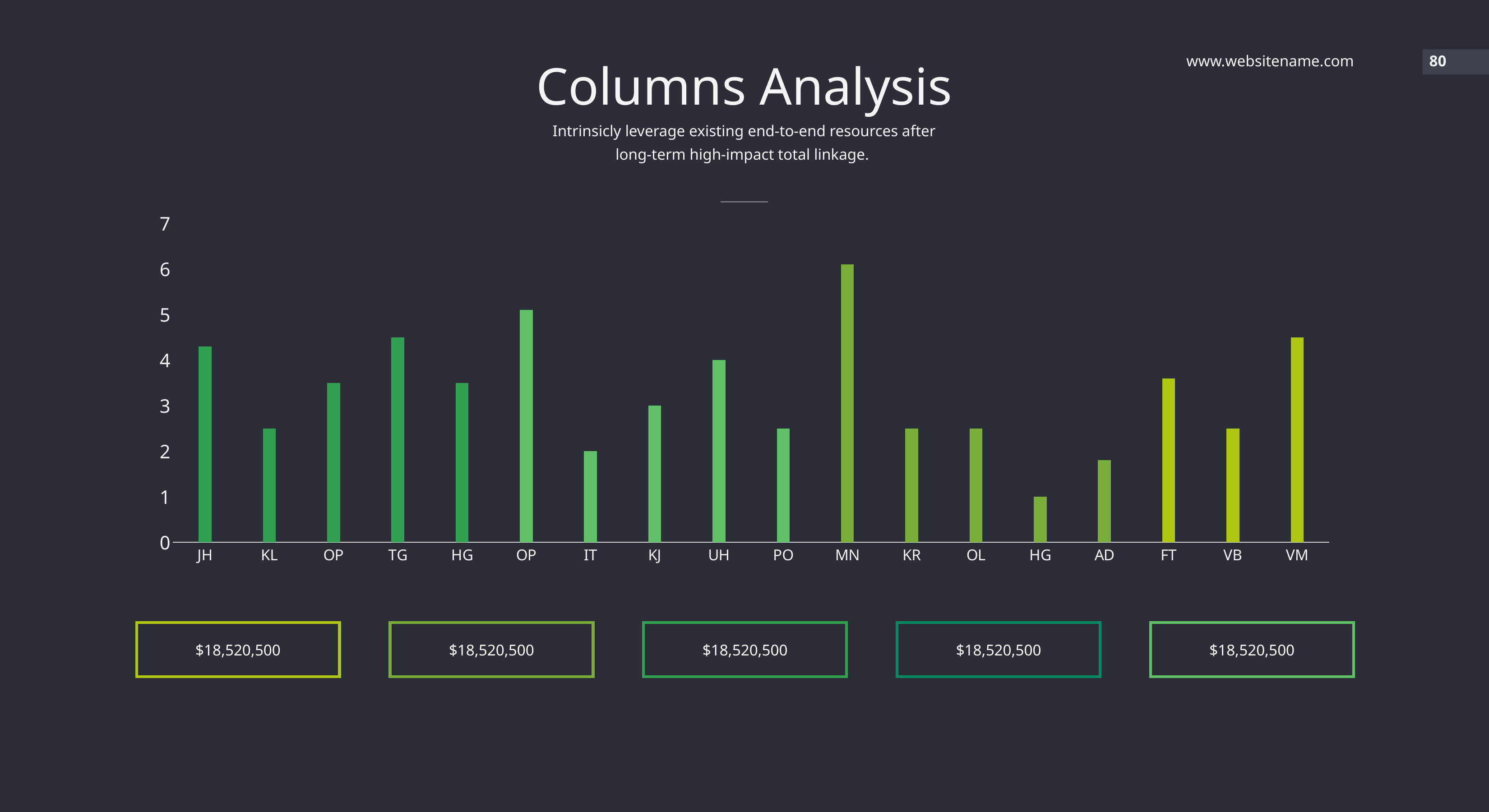
Which category has the highest bar in the chart? MN Is the value for JH greater or less than 4? greater Which is larger, the value for VB or the value for VM? VM Is the value for FT greater or less than 3? greater Is the value for AD greater or less than 2? less How many categories are plotted along the x axis of the chart? 18 What is the title of the chart on the slide? Columns Analysis Which category has the lowest bar in the chart? HG What kind of chart is shown on the slide? bar chart Which is larger, the value for TG or the value for KL? TG